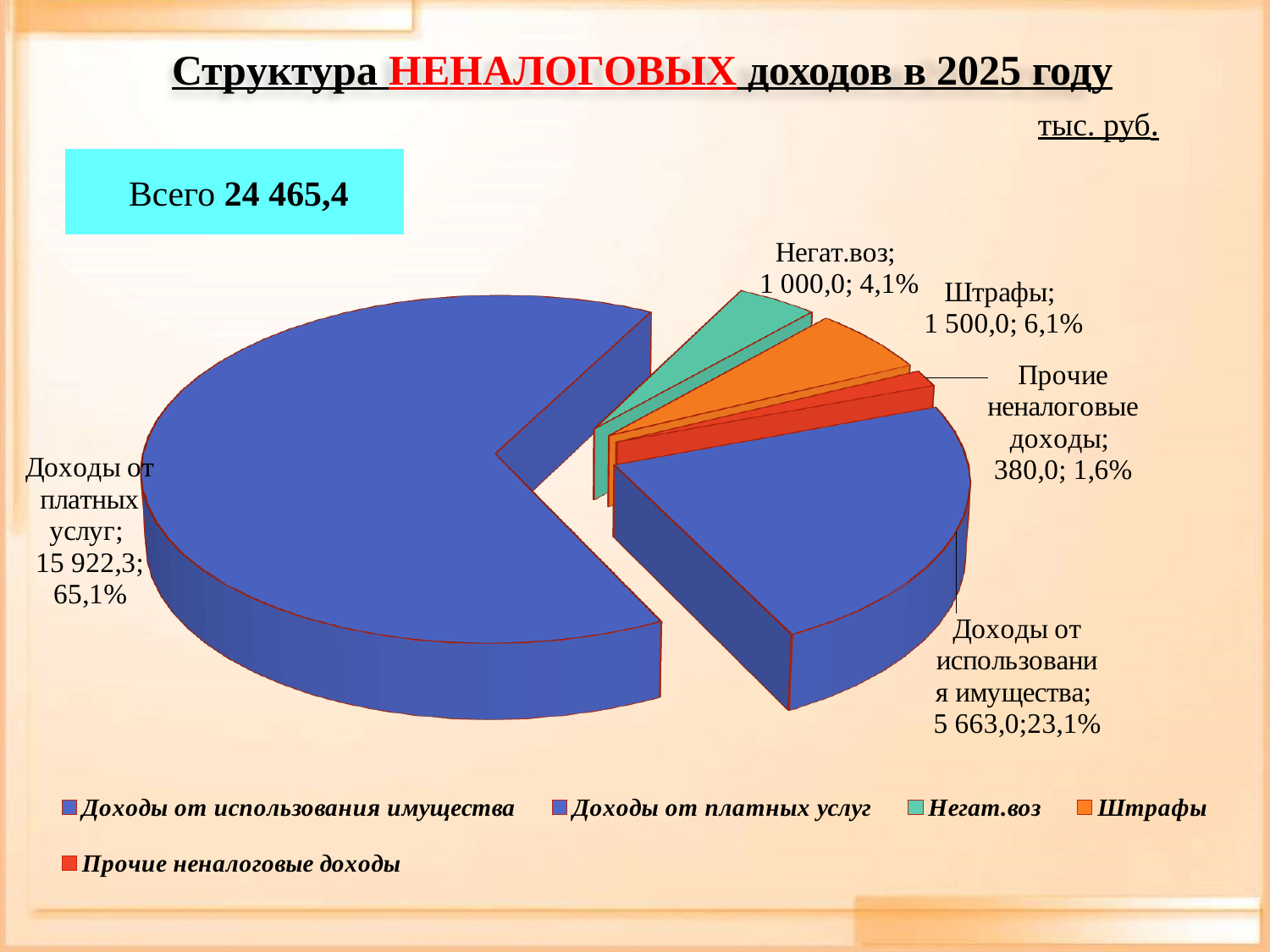
What is the value for Негат.воз? 1 000,0 Which is larger, the value for Штрафы or the value for Негат.воз? Штрафы What is the value for Доходы от использования имущества? 5 663,0 What type of chart is shown on the slide? pie chart What is the value for Штрафы? 1 500,0 What share of the pie does Доходы от использования имущества represent? 23,1% How many categories does the legend list? 5 What share of the pie does Прочие неналоговые доходы represent? 1,6% What is the value for Доходы от платных услуг? 15 922,3 Which category has the smallest slice? Прочие неналоговые доходы Which category has the largest slice? Доходы от платных услуг What is the difference between the values for Штрафы and Негат.воз? 500,0